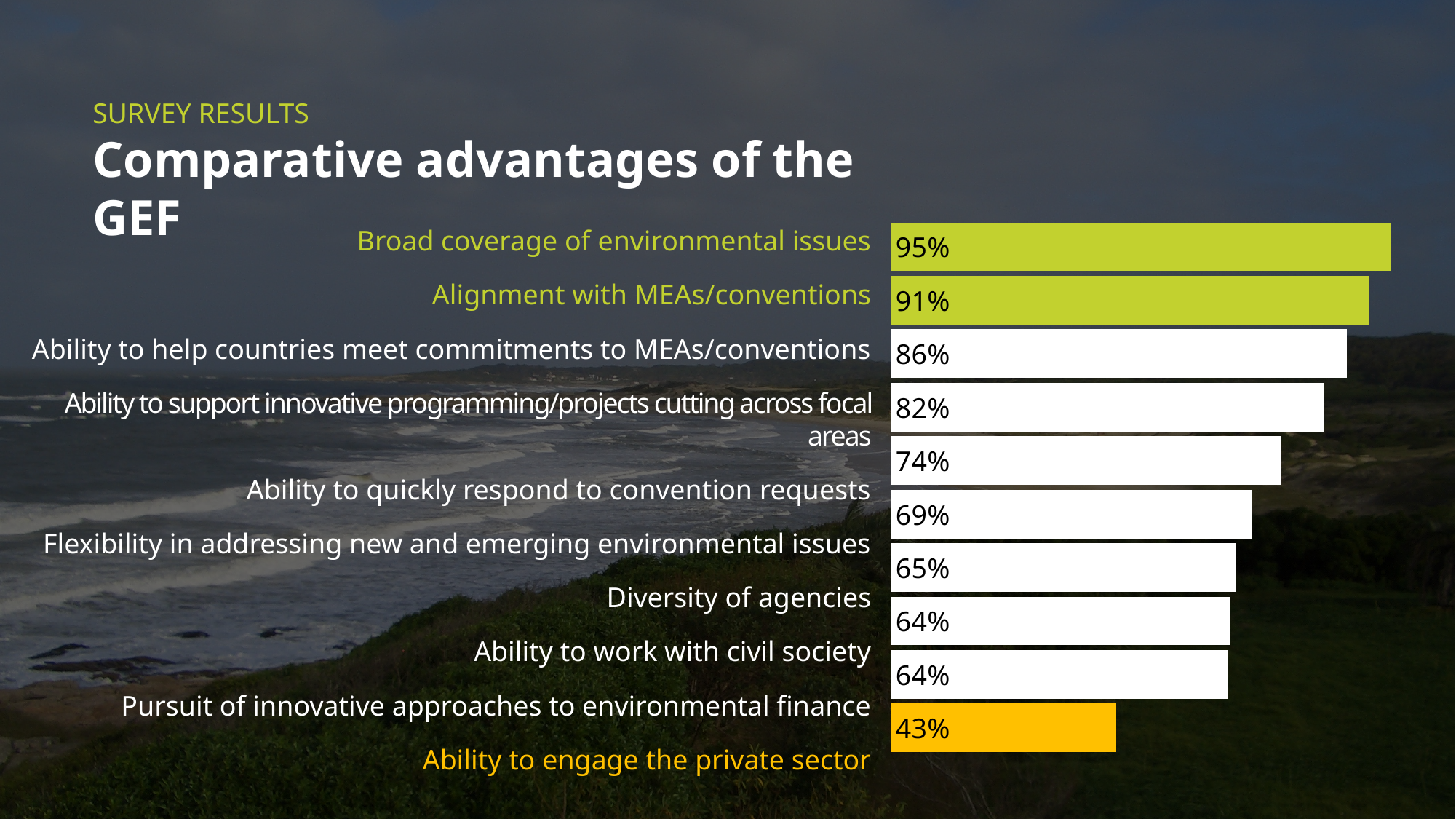
What is the value for Broad coverage of environmental issues? 95% Which category has the lowest value? Ability to engage the private sector Which is larger: the value for Diversity of agencies or the value for Ability to engage the private sector? Diversity of agencies What is the value for Ability to quickly respond to convention requests? 74% How many categories are shown in the chart? 10 What is the value for Ability to engage the private sector? 43% What is the difference between the values for Alignment with MEAs/conventions and Ability to help countries meet commitments to MEAs/conventions? 5% Which category has the highest value? Broad coverage of environmental issues What kind of chart is shown on the slide? Bar chart What is the value for Alignment with MEAs/conventions? 91% What is the difference between the values for Broad coverage of environmental issues and Ability to engage the private sector? 52% What is the title of the chart on the slide? Comparative advantages of the GEF